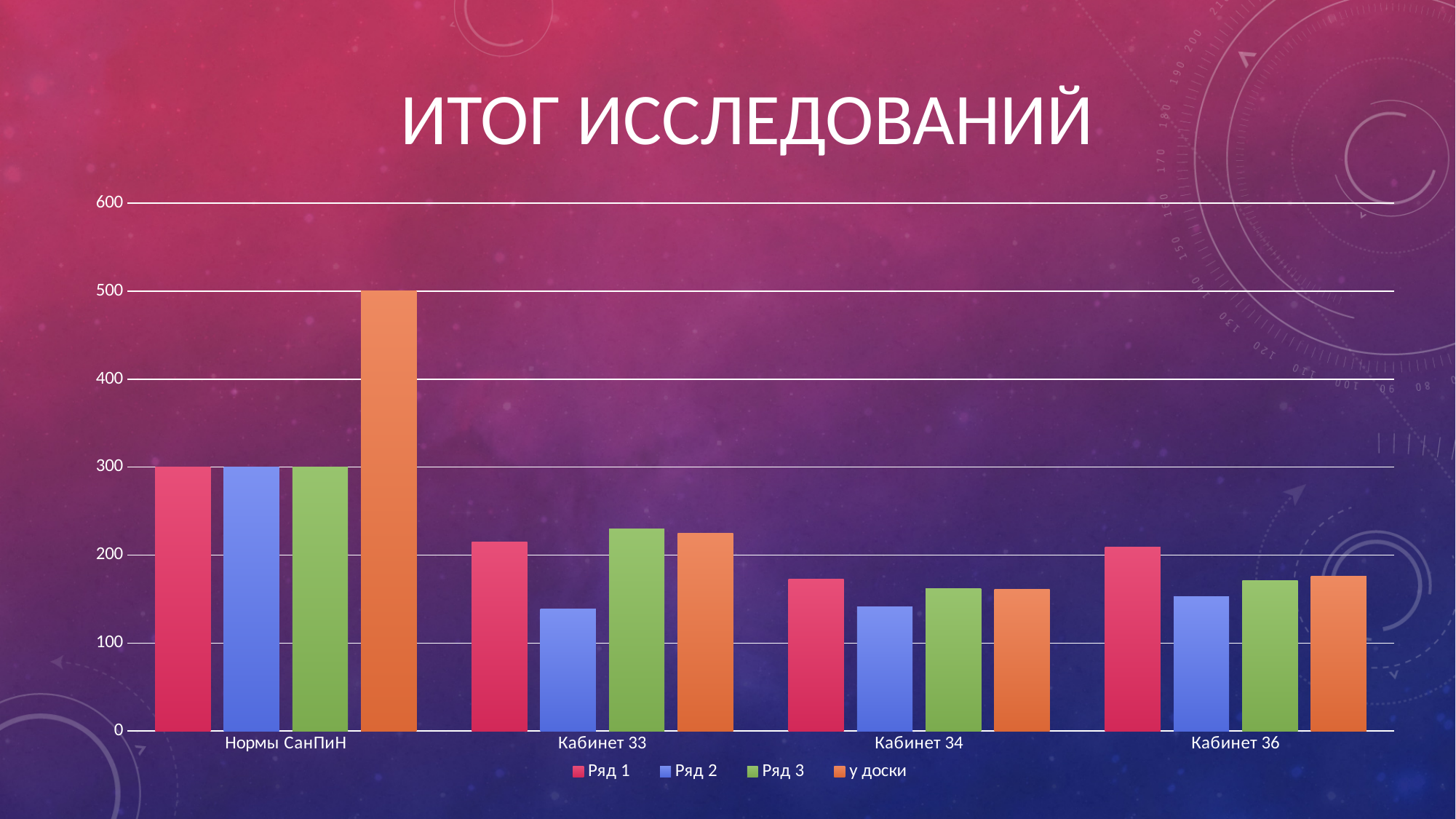
Which series has the highest value for 'Нормы СанПиН'? у доски What is the value of 'у доски' for 'Нормы СанПиН'? 500 What type of chart is shown on the slide? Bar chart What is the value of 'Ряд 1' for 'Нормы СанПиН'? 300 Which is larger: 'Ряд 1' for 'Кабинет 33' or 'Ряд 1' for 'Кабинет 34'? Кабинет 33 How many categories are shown on the x axis? 4 What is the title of the chart? ИТОГ ИССЛЕДОВАНИЙ Is the value of 'Ряд 3' for 'Кабинет 33' greater or less than 200? greater Which series has the lowest value for 'Кабинет 33'? Ряд 2 Is the value of 'Ряд 2' for 'Кабинет 33' greater or less than 200? less What is the difference between 'у доски' and 'Ряд 1' for 'Нормы СанПиН'? 200 How many series does the legend list? 4